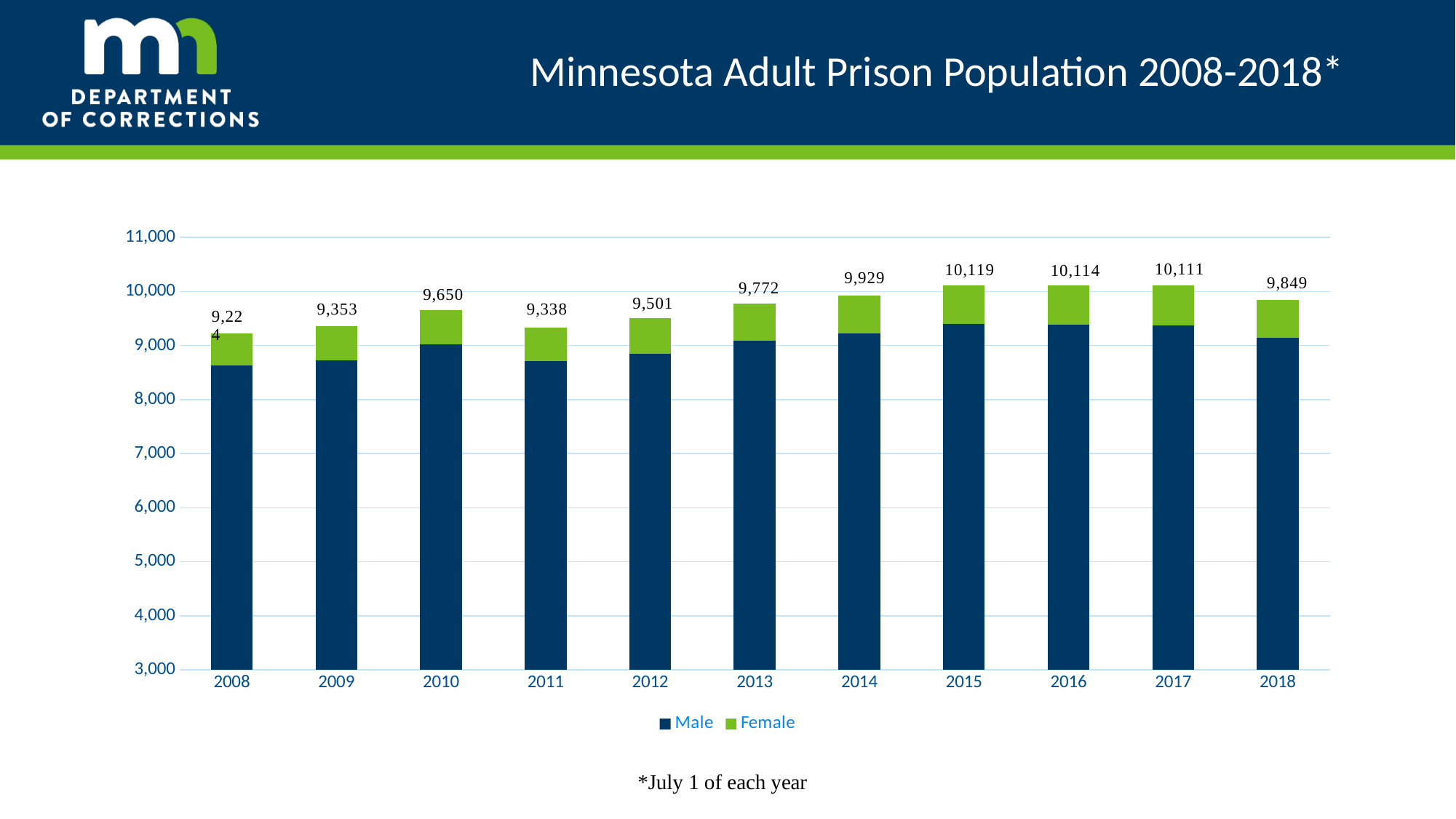
What is the total adult prison population shown for 2015? 10,119 How many years are shown on the x axis? 11 Which year has a larger total prison population, 2010 or 2012? 2010 Which year has the highest total prison population? 2015 What is the difference between the total prison population in 2018 and in 2008? 625 What is the total adult prison population shown for 2018? 9,849 What is the difference between the total prison population in 2015 and in 2014? 190 Which year has the lowest total prison population? 2008 How many series does the legend list? 2 What is the total adult prison population shown for 2011? 9,338 Is the Male value for 2015 greater or less than 9,000? greater Is the Male value for 2008 greater or less than 9,000? less